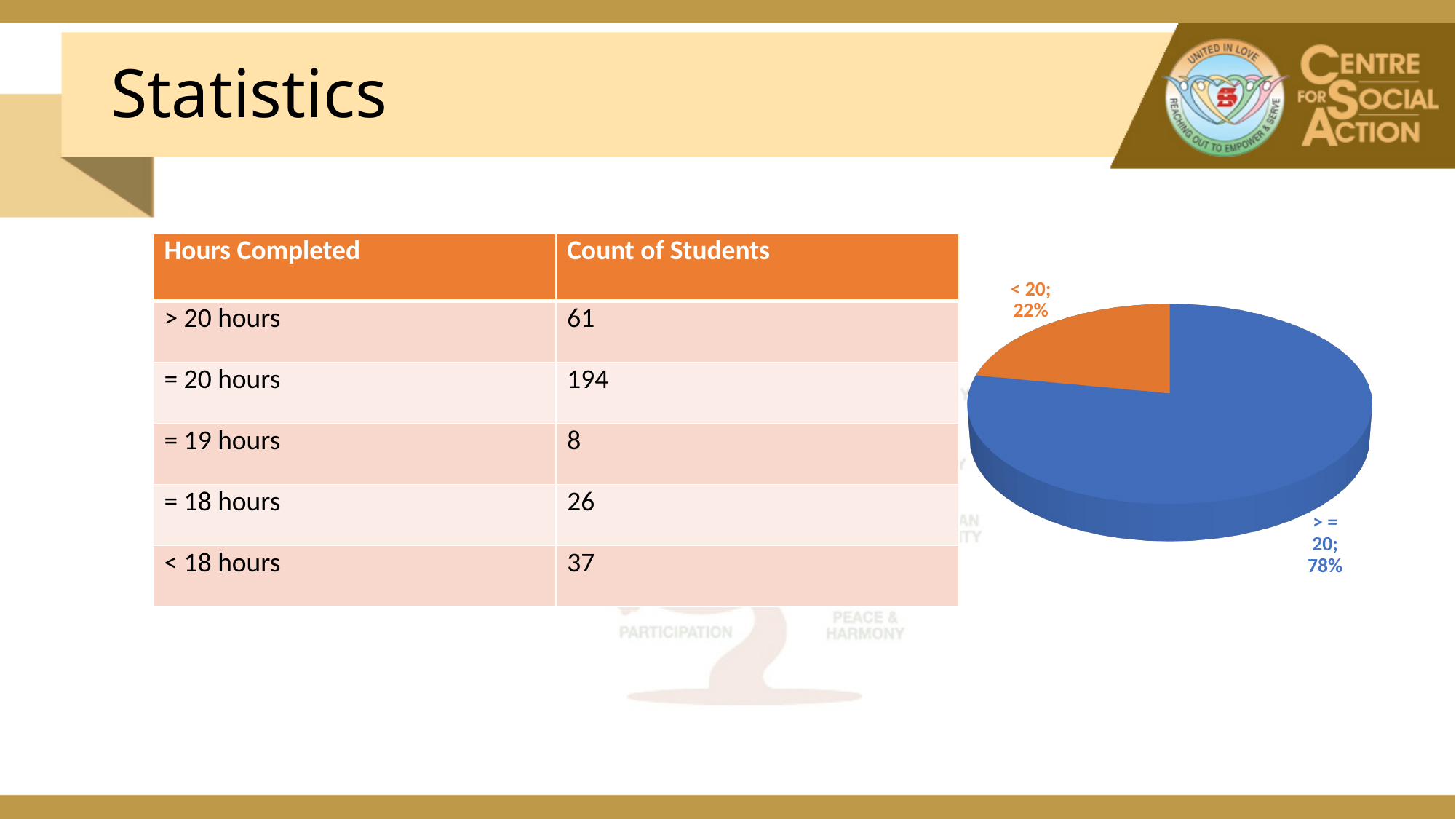
Which slice of the pie chart is the largest? > = 20 What colour is the "> = 20" slice in the pie chart? blue What colour is the "< 20" slice in the pie chart? orange How many slices does the pie chart have? 2 What share of the pie chart is the "< 20" slice? 22% What is the difference in percentage points between the "> = 20" slice and the "< 20" slice in the pie chart? 56 In the pie chart, which slice is larger, "< 20" or "> = 20"? > = 20 What share of the pie chart is the "> = 20" slice? 78% Which slice of the pie chart is the smallest? < 20 What kind of chart is shown on the slide? pie chart